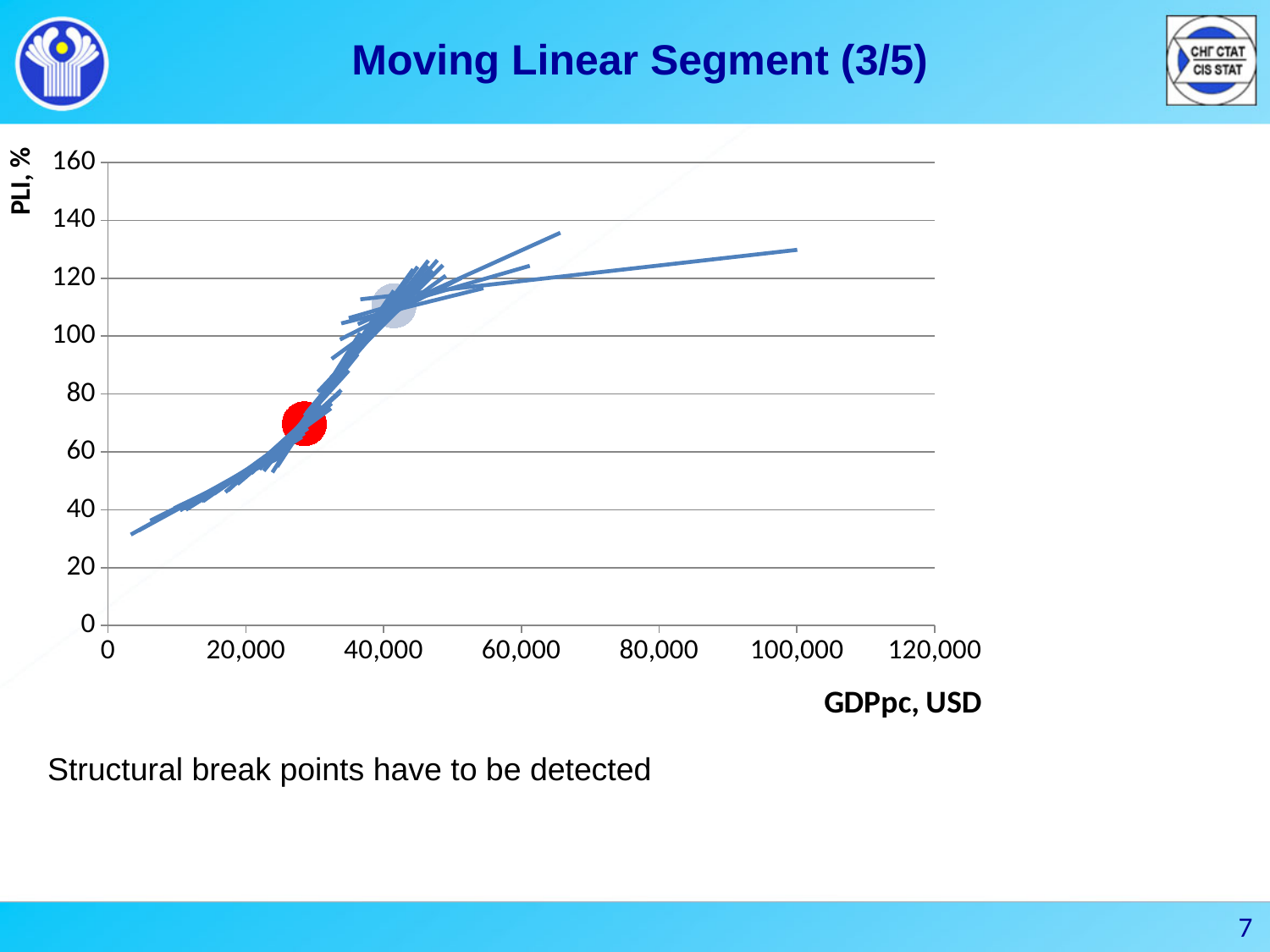
Is the PLI value at the red circle larger or smaller than the PLI value at the grey circle? smaller Is the PLI value at the left-hand end of the plotted segments, near GDPpc 0, greater or less than 40? less Is the PLI value at the red circle greater or less than 60? greater Is the PLI value at the grey circle greater or less than 100? greater What kind of chart is shown on the slide? line chart What is the label of the horizontal axis of the chart? GDPpc, USD What is the label of the vertical axis of the chart? PLI, % Do the PLI values generally rise or fall as GDPpc increases along the x axis? rise